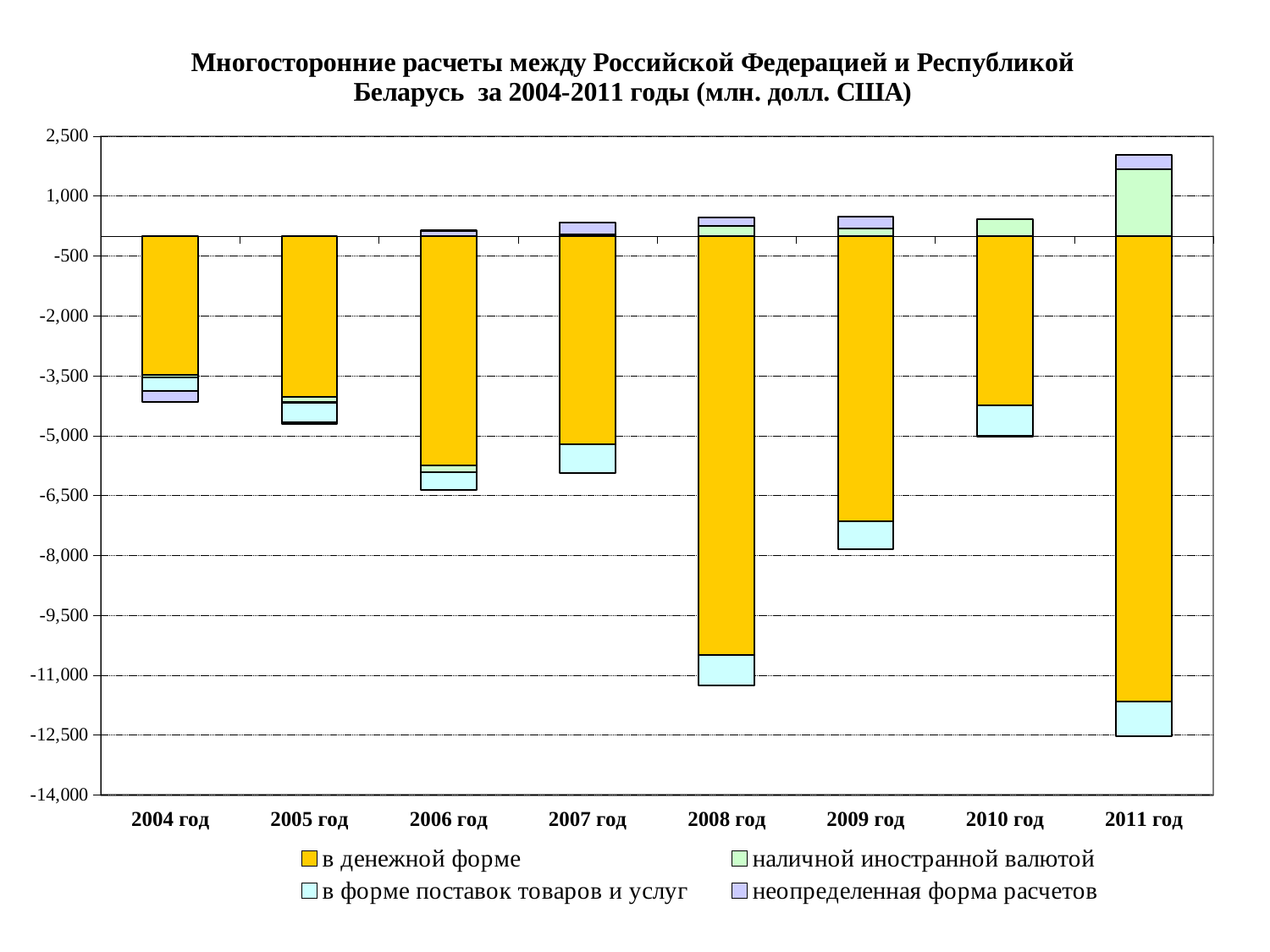
What kind of chart is shown on the slide? Stacked bar chart Which year has the largest positive segment for 'наличной иностранной валютой'? 2011 год Which year's stacked bar extends further below zero, 2008 год or 2009 год? 2008 год How many years (categories) are shown on the x axis? 8 Which series is shown in yellow? в денежной форме How many series does the legend list? 4 Is the value for 'в денежной форме' in 2010 год greater or less than -5,000? greater Which year's stacked bar extends further below zero, 2004 год or 2007 год? 2007 год Is the value for 'в денежной форме' in 2008 год greater or less than -9,500? less What unit is given in the chart title? млн. долл. США Is the value for 'в денежной форме' in 2011 год greater or less than -9,500? less Which year has the stacked bar that extends furthest below zero? 2011 год